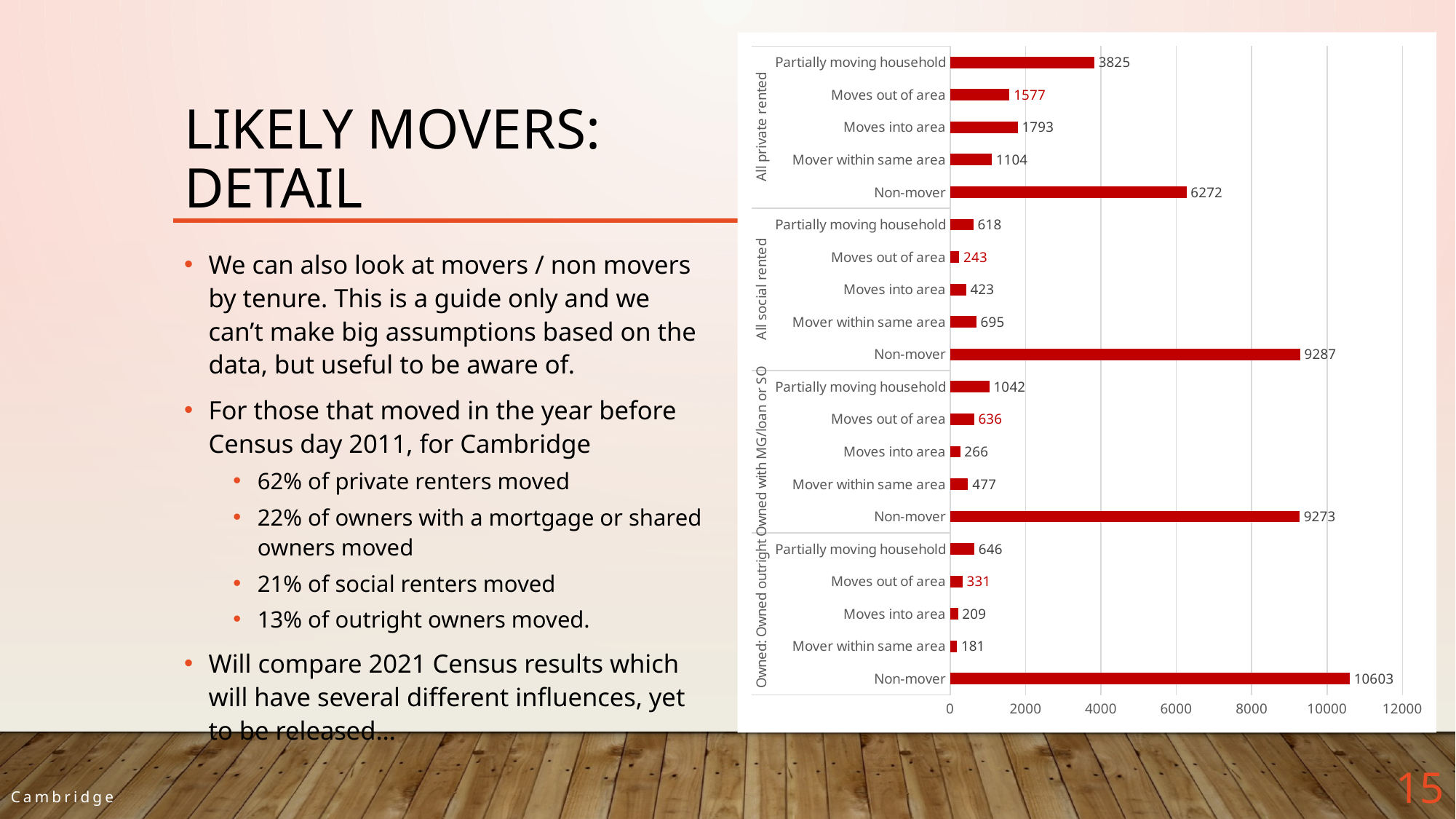
What type of chart is shown on the slide? Bar chart How many bars are plotted in the chart? 20 What is the value for Non-mover in the All private rented group? 6272 What is the value for Partially moving household in the Owned with MG/loan or SO group? 1042 What is the value for Moves out of area in the All social rented group? 243 Is the value for Partially moving household in the All private rented group greater or less than 4000? less What is the maximum value shown on the horizontal axis? 12000 Which bar has the highest value in the chart? Non-mover (Owned outright), 10603 Which is larger: Non-mover in All social rented or Non-mover in Owned with MG/loan or SO? Non-mover in All social rented (9287) What is the value for Mover within same area in the Owned outright group? 181 What is the difference between Moves into area and Moves out of area in the All private rented group? 216 Which bar has the lowest value in the chart? Mover within same area (Owned outright), 181